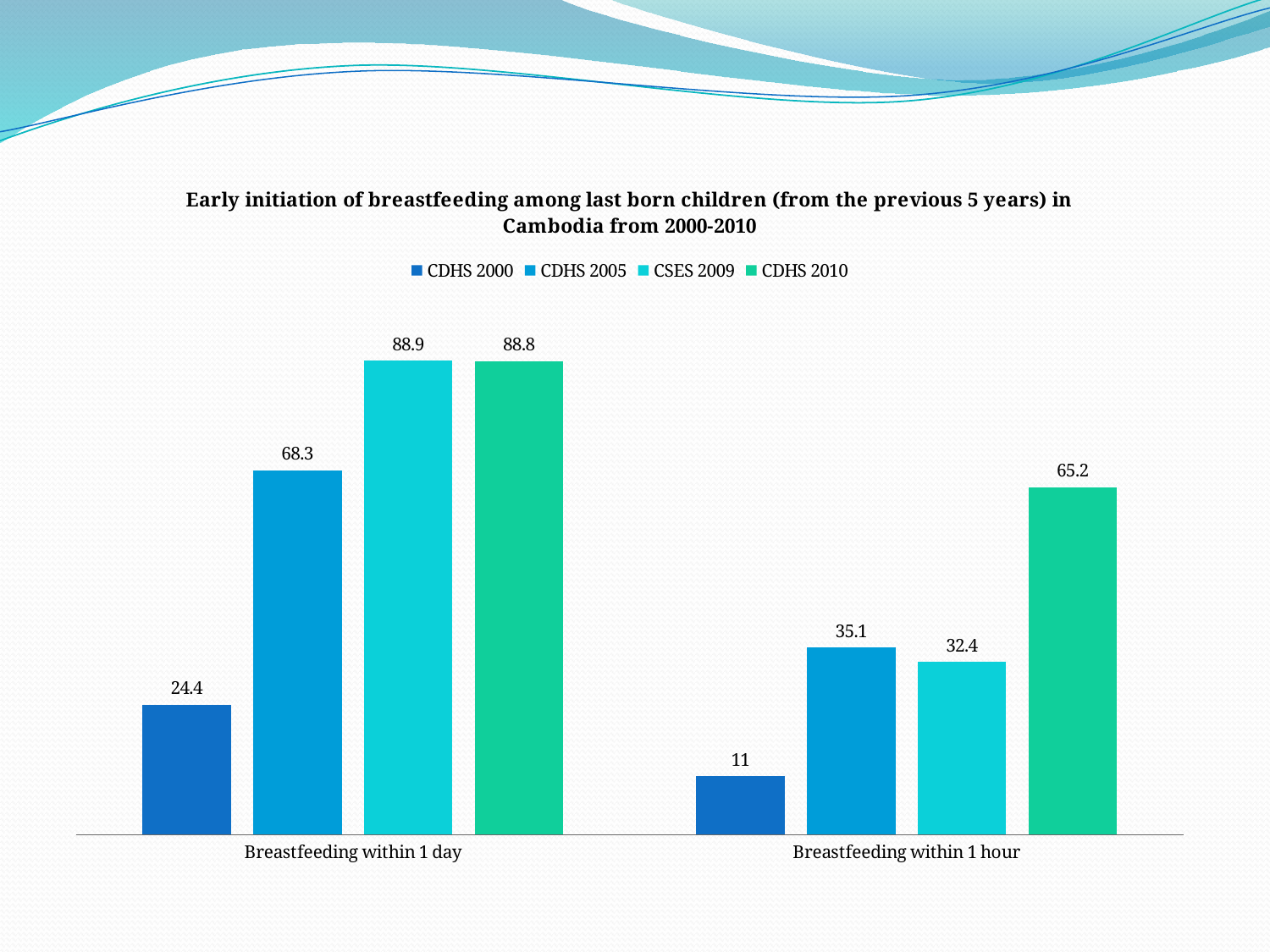
What is the difference between the CDHS 2005 and CDHS 2000 values in the 'Breastfeeding within 1 day' category? 43.9 What is the title of the chart? Early initiation of breastfeeding among last born children (from the previous 5 years) in Cambodia from 2000-2010 What is the value for CDHS 2000 in the 'Breastfeeding within 1 day' category? 24.4 What is the value for CSES 2009 in the 'Breastfeeding within 1 hour' category? 32.4 What kind of chart is shown on the slide? Bar chart Which series has the highest value in the 'Breastfeeding within 1 day' category? CSES 2009 Which series has the lowest value in the 'Breastfeeding within 1 hour' category? CDHS 2000 How many series does the legend list? 4 How many categories are shown on the x axis? 2 What is the difference between the CDHS 2010 and CDHS 2005 values in the 'Breastfeeding within 1 hour' category? 30.1 What is the value for CDHS 2010 in the 'Breastfeeding within 1 hour' category? 65.2 Which is larger in the 'Breastfeeding within 1 hour' category: CDHS 2005 or CSES 2009? CDHS 2005